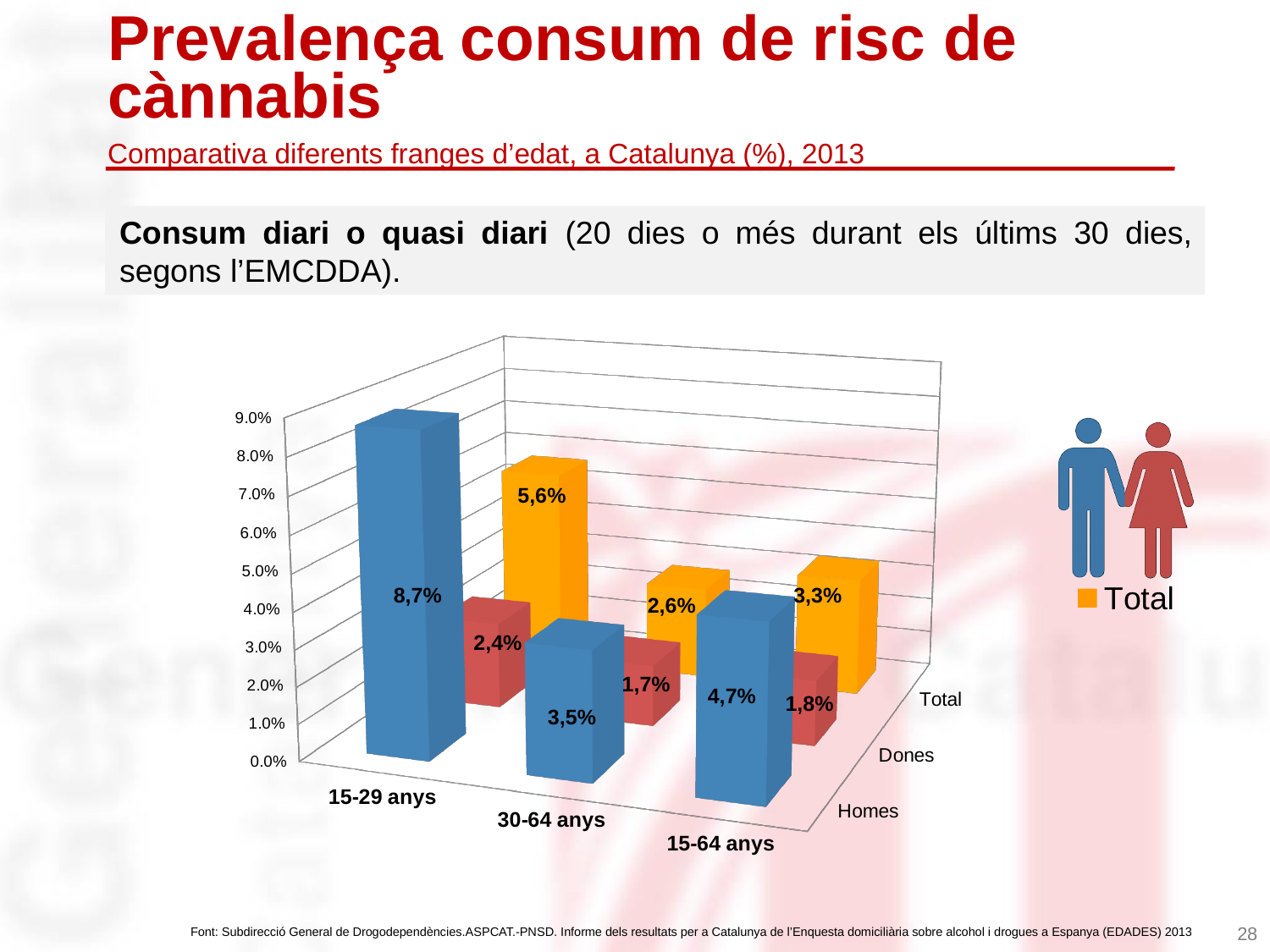
What colour are the bars for the Total series? Orange Which age group has the lowest value for Dones? 30-64 anys Which age group has the highest value for Homes? 15-29 anys How many age groups are shown on the x axis of the chart? 3 What is the Total value for the 15-64 anys age group? 3,3% What is the value for Homes in the 15-29 anys age group? 8,7% Is the value for Homes in the 15-29 anys age group greater or less than 8.0%? greater What is the Total value for the 15-29 anys age group? 5,6% What kind of chart is shown on the slide? Bar chart What is the value for Dones in the 30-64 anys age group? 1,7% What is the difference between the Homes and Dones values in the 15-29 anys age group? 6,3% Which is larger: the Total value for 30-64 anys or the Total value for 15-64 anys? 15-64 anys